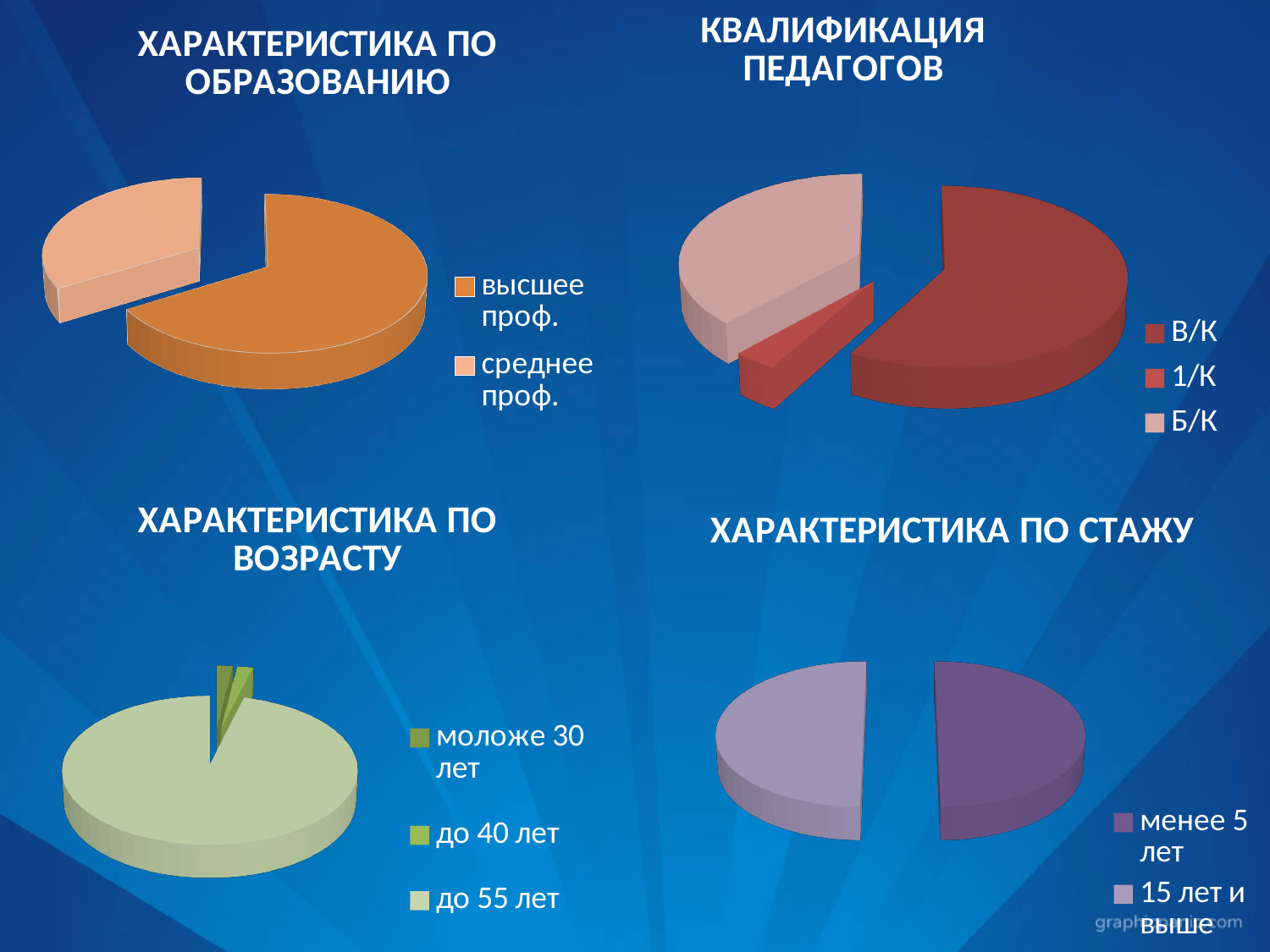
In the chart titled "ХАРАКТЕРИСТИКА ПО ВОЗРАСТУ", which category has the largest slice? до 55 лет How many slices does the chart titled "ХАРАКТЕРИСТИКА ПО ОБРАЗОВАНИЮ" have? 2 In the chart titled "КВАЛИФИКАЦИЯ ПЕДАГОГОВ", which category has the largest slice? В/К How many entries does the legend of the chart titled "КВАЛИФИКАЦИЯ ПЕДАГОГОВ" list? 3 In the chart titled "ХАРАКТЕРИСТИКА ПО ОБРАЗОВАНИЮ", which category has the largest slice? высшее проф. How many entries does the legend of the chart titled "ХАРАКТЕРИСТИКА ПО СТАЖУ" list? 2 In the chart titled "ХАРАКТЕРИСТИКА ПО ВОЗРАСТУ", which slice is larger: до 55 лет or до 40 лет? до 55 лет What is the title of the chart in the bottom-right of the slide? ХАРАКТЕРИСТИКА ПО СТАЖУ In the chart titled "КВАЛИФИКАЦИЯ ПЕДАГОГОВ", which slice is larger: Б/К or 1/К? Б/К How many categories does the chart titled "ХАРАКТЕРИСТИКА ПО ВОЗРАСТУ" show? 3 What kind of chart is the chart titled "ХАРАКТЕРИСТИКА ПО ОБРАЗОВАНИЮ"? Pie chart In the chart titled "КВАЛИФИКАЦИЯ ПЕДАГОГОВ", which category has the smallest slice? 1/К